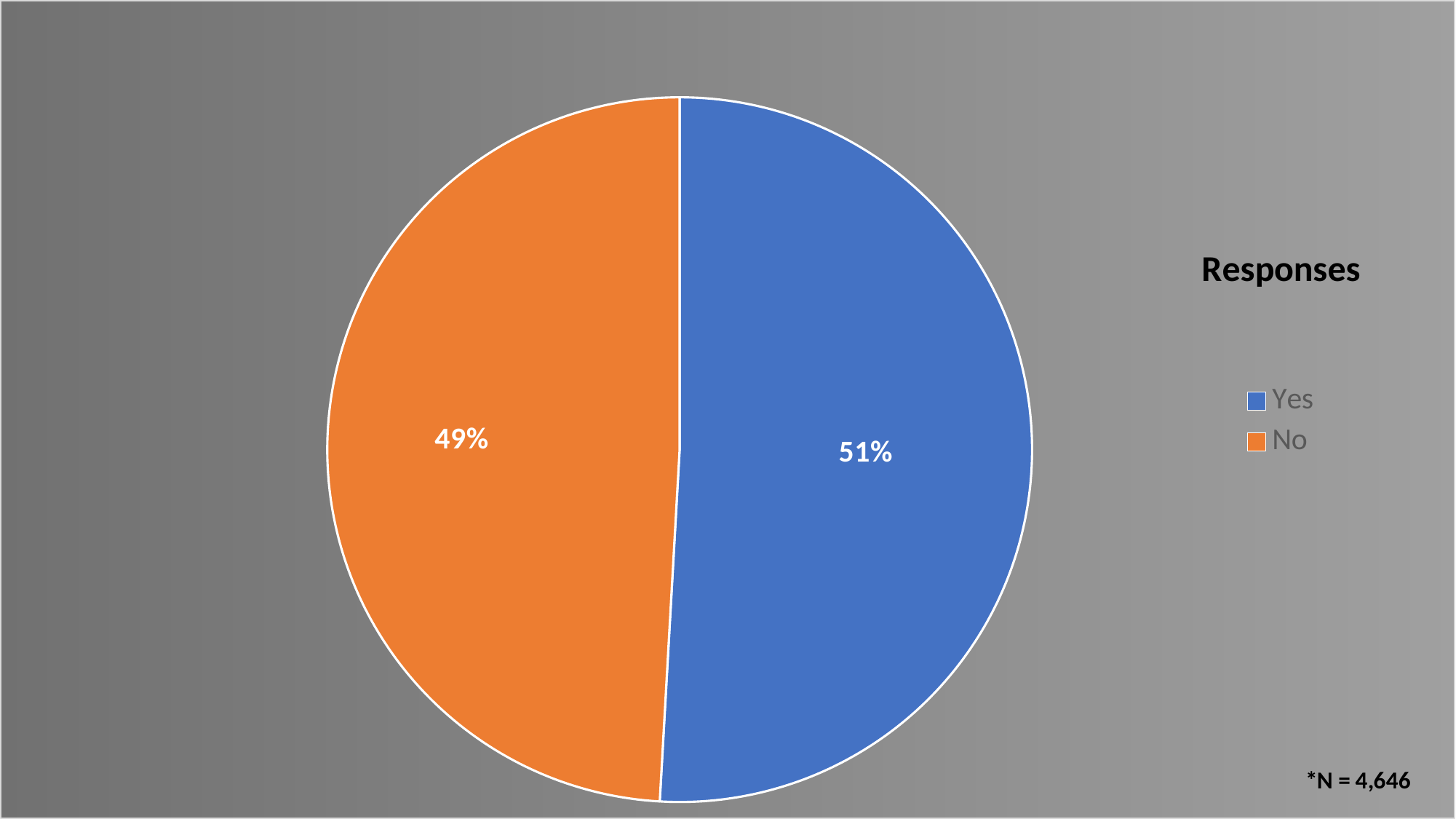
What percentage of responses are "No"? 49% Is the share for "Yes" larger or smaller than the share for "No"? larger What kind of chart is shown on the slide? pie chart How many entries does the legend list? 2 What is the title of the chart? Responses Which response has the smaller share of the pie? No What percentage of responses are "Yes"? 51% What is the difference in percentage points between the "Yes" and "No" shares? 2% What is the sample size (N) noted on the slide? 4,646 How many slices does the pie chart have? 2 Which response has the larger share of the pie? Yes What colour is the "No" slice? orange